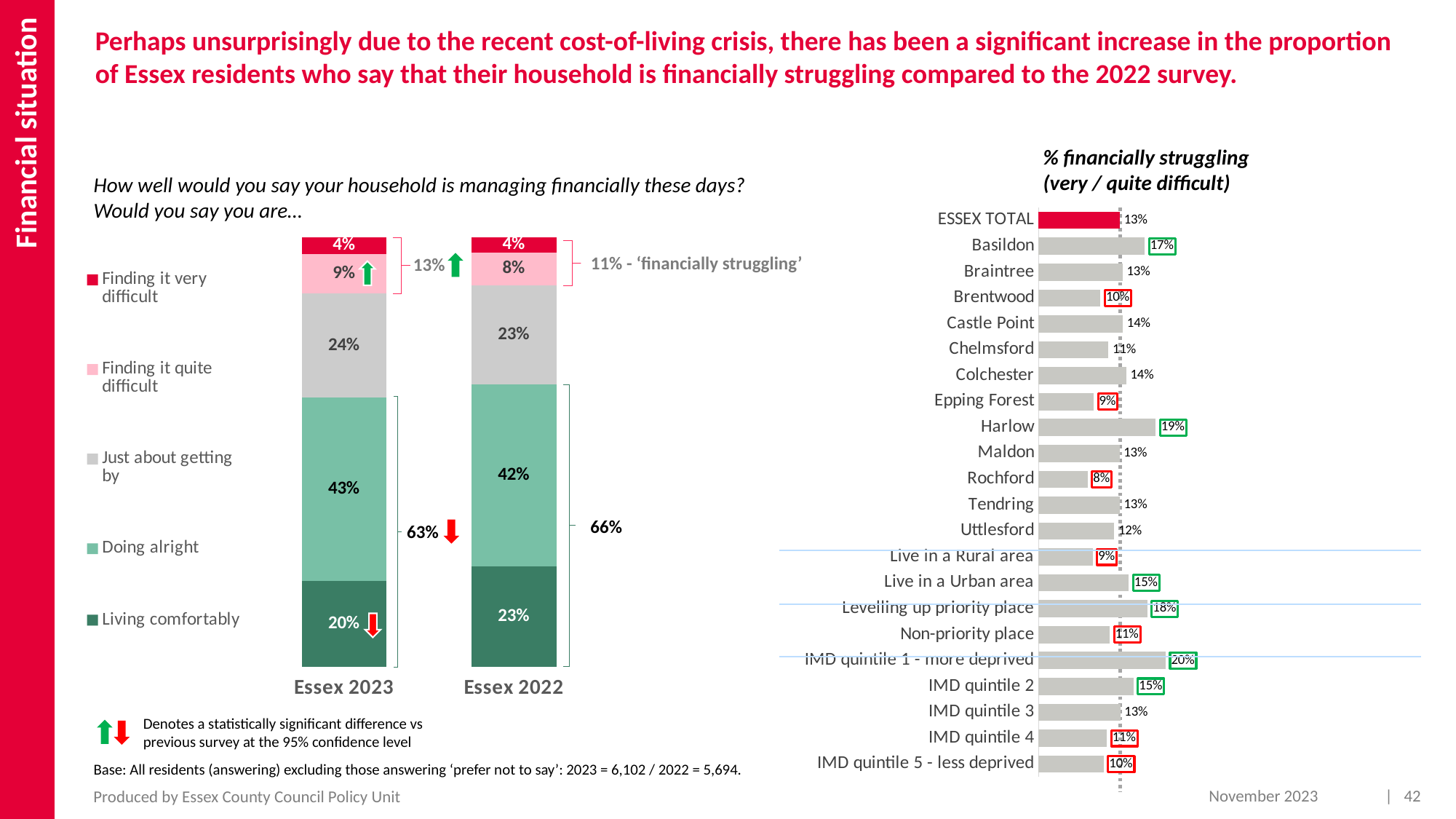
In the stacked bar chart on the left, which year has the larger 'Finding it quite difficult' share, Essex 2023 or Essex 2022? Essex 2023 In the '% financially struggling' chart on the right, what is the value for ESSEX TOTAL? 13% In the stacked bar chart on the left, what is the difference between the 'Just about getting by' share in Essex 2023 and Essex 2022? 1% In the stacked bar chart on the left, what percentage of Essex 2023 respondents said they were 'Doing alright'? 43% In the '% financially struggling' chart on the right, how many categories are plotted? 22 In the '% financially struggling' chart on the right, which category has the highest value? IMD quintile 1 - more deprived In the stacked bar chart on the left, what percentage of Essex 2022 respondents said they were 'Living comfortably'? 23% In the '% financially struggling' chart on the right, what is the value for Harlow? 19% In the stacked bar chart on the left, how many series does the legend list? 5 What kind of chart is the '% financially struggling' chart on the right? Bar chart In the '% financially struggling' chart on the right, which category has the lowest value? Rochford In the '% financially struggling' chart on the right, what is the difference between the values for 'Live in a Urban area' and 'Live in a Rural area'? 6%